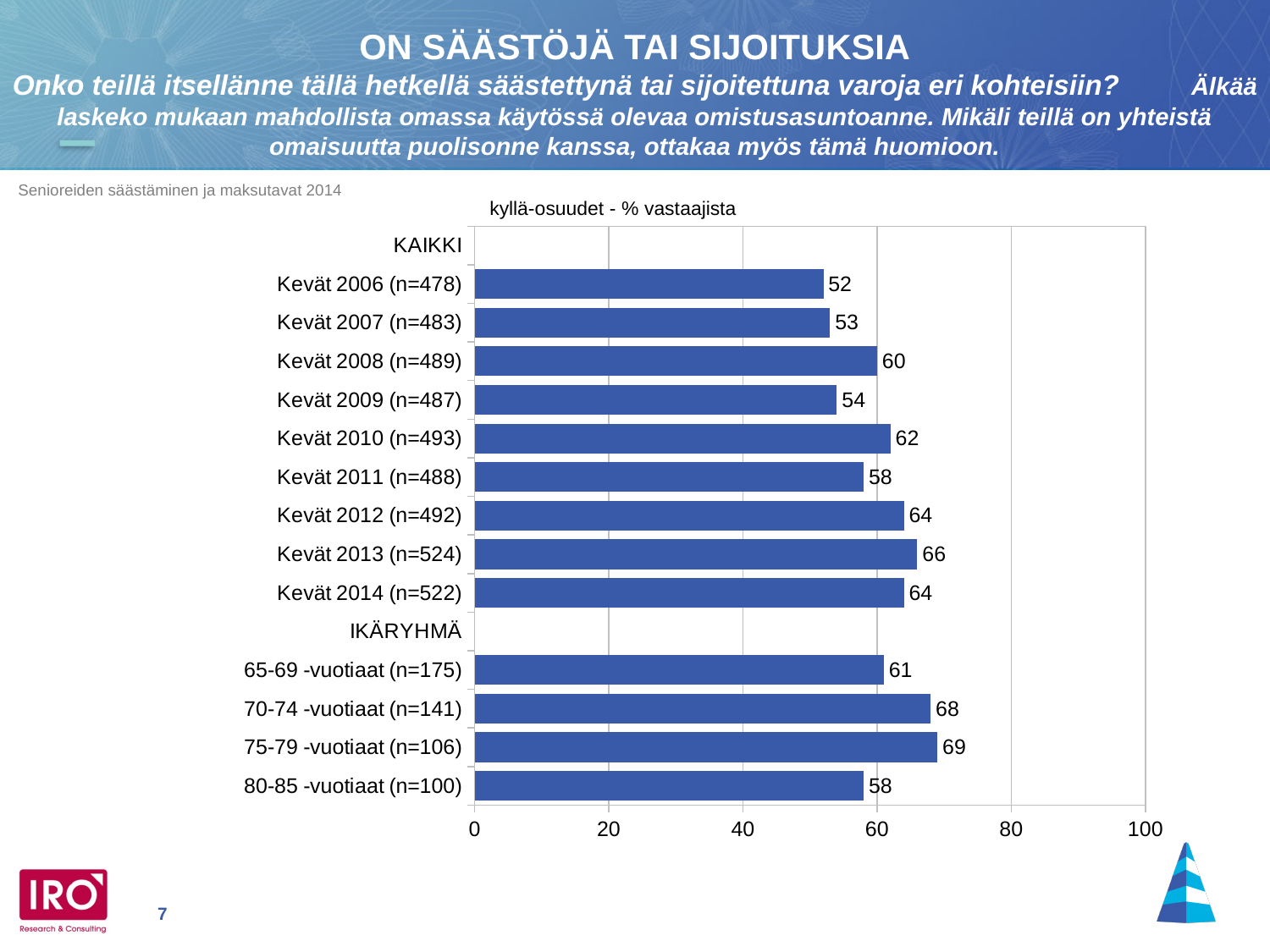
How many bars with data values are plotted in the chart? 13 Which category has the highest value in the chart? 75-79 -vuotiaat (n=106) What is the value for 75-79 -vuotiaat (n=106)? 69 Which category has the lowest value in the chart? Kevät 2006 (n=478) What is the value for Kevät 2014 (n=522)? 64 What is the value for Kevät 2008 (n=489)? 60 What is the difference between the values for Kevät 2013 (n=524) and Kevät 2006 (n=478)? 14 Is the value for Kevät 2010 (n=493) greater or less than 60? greater What is the maximum value shown on the x axis? 100 Which is larger, the value for 70-74 -vuotiaat (n=141) or the value for 80-85 -vuotiaat (n=100)? 70-74 -vuotiaat (n=141) What is the title of the chart? kyllä-osuudet - % vastaajista What kind of chart is shown on the slide? bar chart